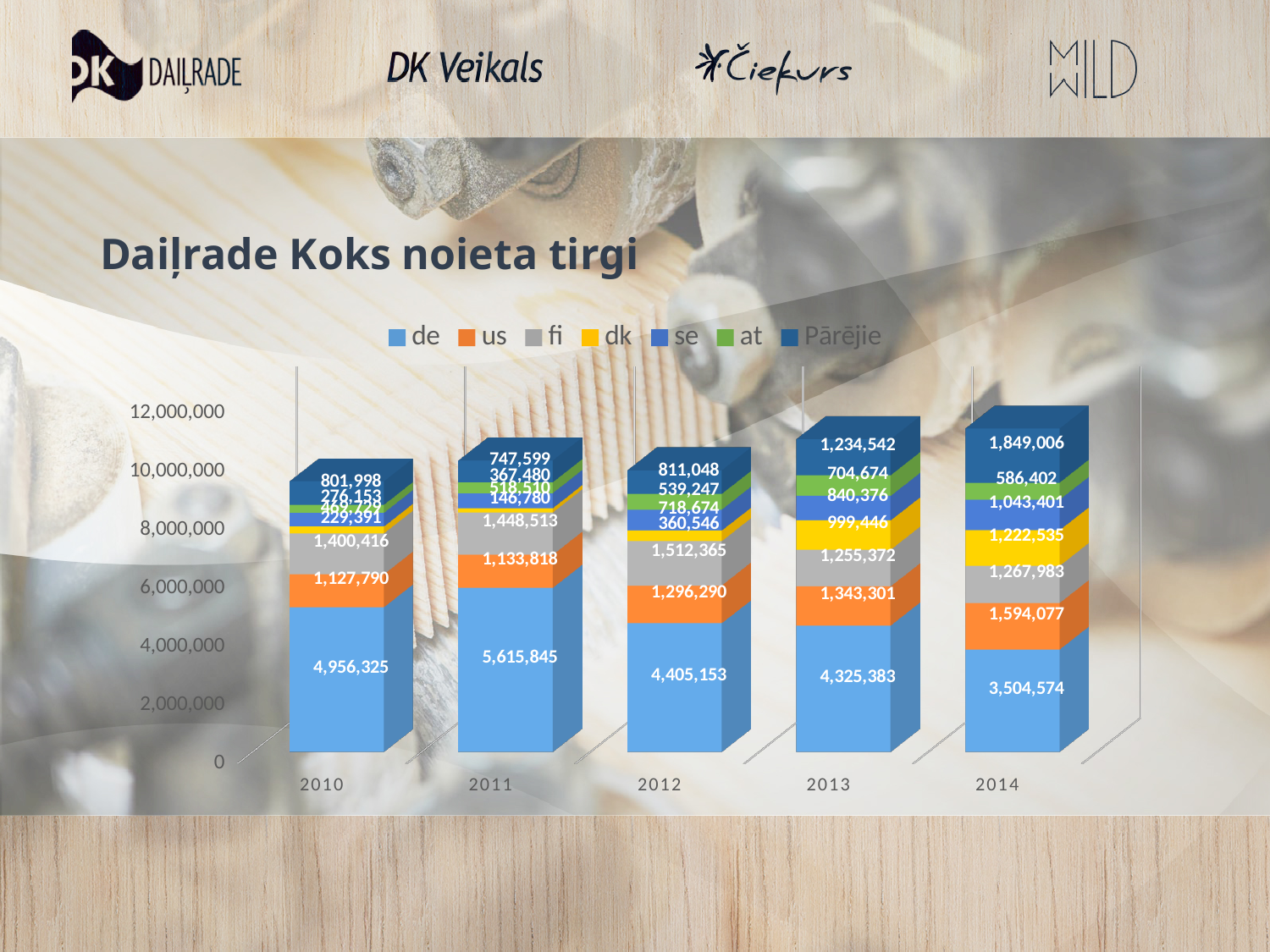
In which year is the de value lowest? 2014 What is the value for Pārējie in 2014? 1,849,006 What kind of chart is shown? Stacked bar chart What is the difference between the us value in 2014 and the us value in 2010? 466,287 What is the value for dk in 2013? 999,446 What is the value for de in 2011? 5,615,845 In which year is the de value highest? 2011 Which is larger, the fi value in 2012 or the fi value in 2013? 2012 How many years are shown on the x axis? 5 How many series does the legend list? 7 What is the total of the stacked bar for 2014? 11,067,978 Does the de value rise or fall from 2011 to 2014? Fall